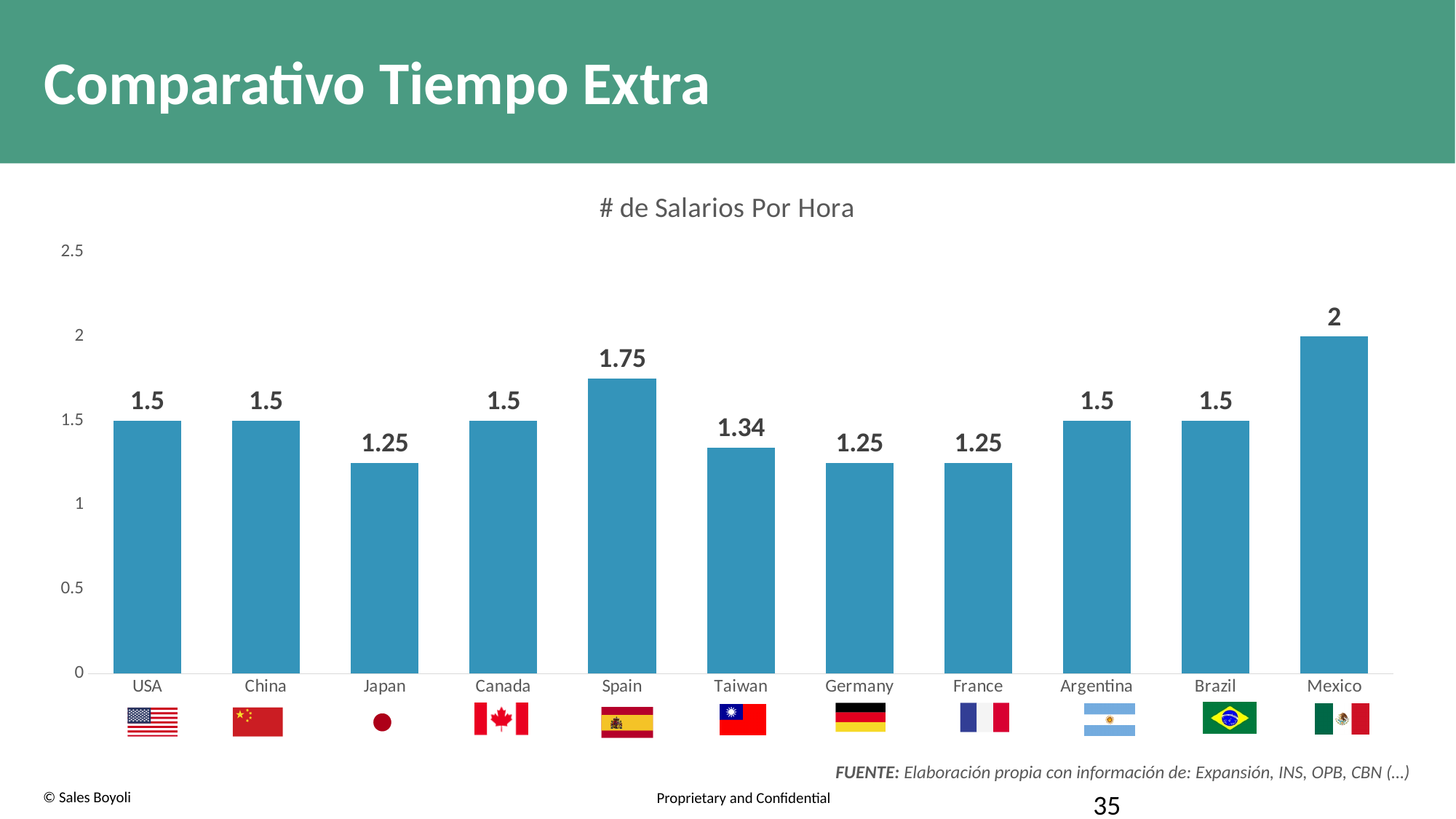
Which country has the highest value? Mexico What is the title of the chart? # de Salarios Por Hora What is the value for Mexico? 2 What is the value for Taiwan? 1.34 What is the value for Spain? 1.75 What is the value for Germany? 1.25 How many countries are shown on the chart? 11 What is the difference between the values for Mexico and Spain? 0.25 What is the difference between the values for Taiwan and Japan? 0.09 Is the value for Mexico greater or less than 1.5? greater What kind of chart is shown on the slide? Bar chart Which is larger, the value for Spain or the value for Canada? Spain